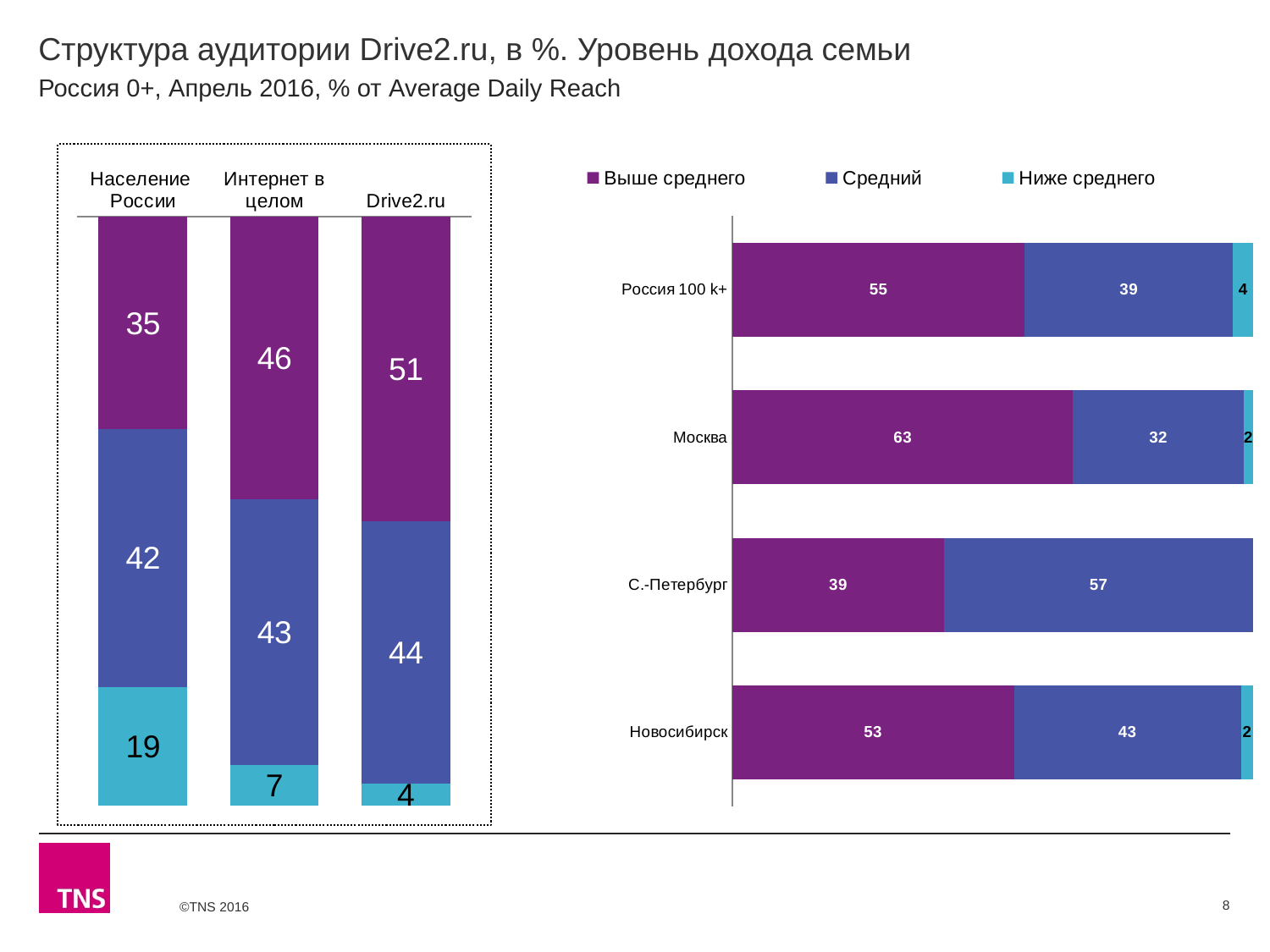
In the left chart, what is the total of the stacked bar for Население России? 96 In the left chart, what is the value of the middle (blue) segment for Интернет в целом? 43 How many series does the legend of the right chart list? 3 What type of chart is the right chart? Stacked bar chart In the right chart, which category has the highest value for Выше среднего? Москва In the left chart, what is the value of the top (purple) segment for Drive2.ru? 51 In the left chart, how many stacked bars are shown? 3 In the right chart, what is the value of Выше среднего for Москва? 63 In the right chart, what is the value of Средний for С.-Петербург? 57 In the right chart, which category has the lowest value for Выше среднего? С.-Петербург In the right chart, what is the difference between the Выше среднего values for Москва and Новосибирск? 10 In the left chart, what is the value of the bottom (light blue) segment for Население России? 19